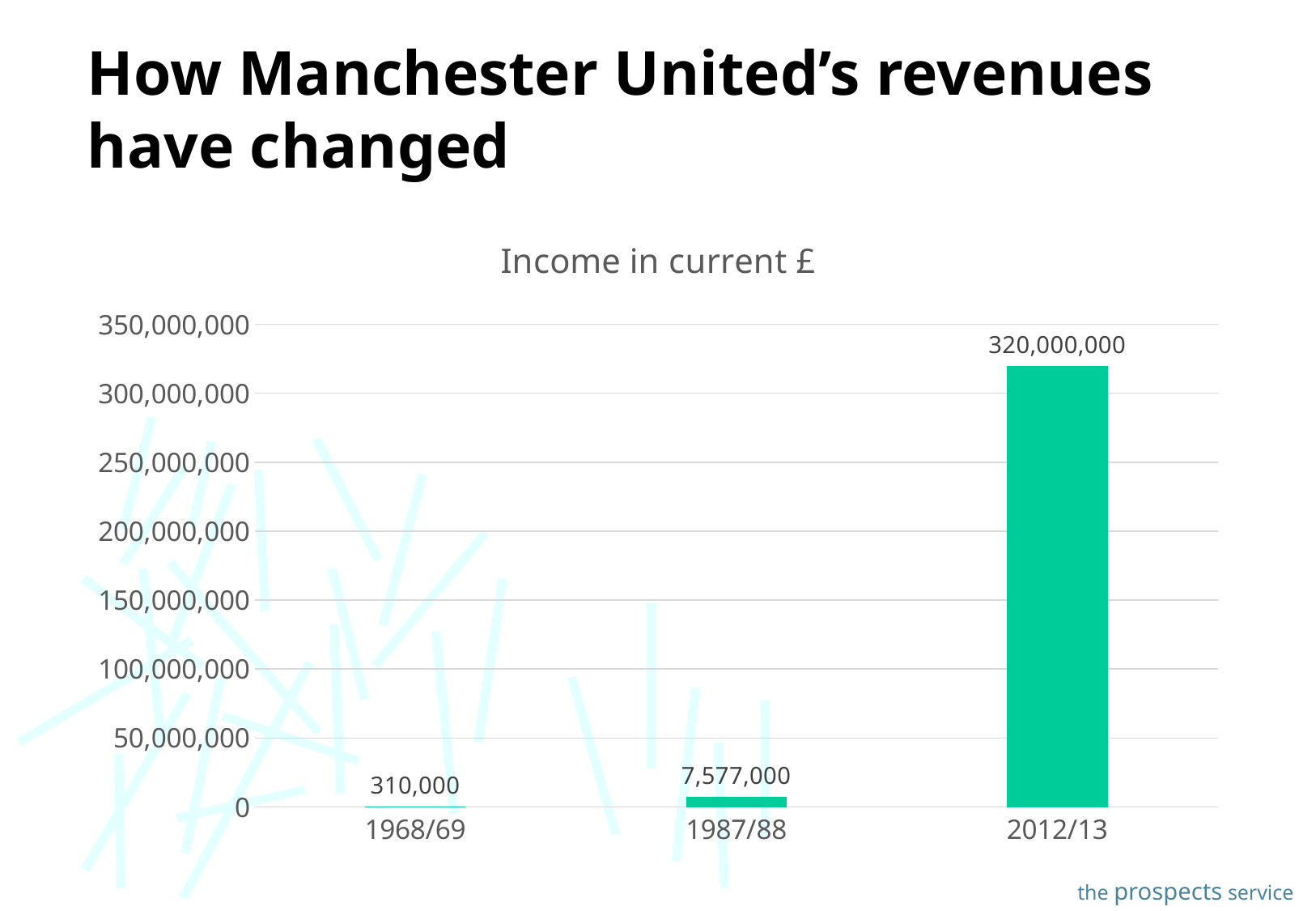
What kind of chart is shown on the slide? bar chart What is the income for 2012/13? 320,000,000 What is the difference in income between 1987/88 and 1968/69? 7,267,000 Which season has the lowest income? 1968/69 What is the income for 1968/69? 310,000 Which season has the highest income? 2012/13 Which is larger, the income for 1987/88 or for 1968/69? 1987/88 What is the income for 1987/88? 7,577,000 What is the difference in income between 2012/13 and 1987/88? 312,423,000 Is the income for 2012/13 greater or less than 300,000,000? greater How many seasons are shown on the chart? 3 Do the income values rise or fall from 1968/69 to 2012/13? rise